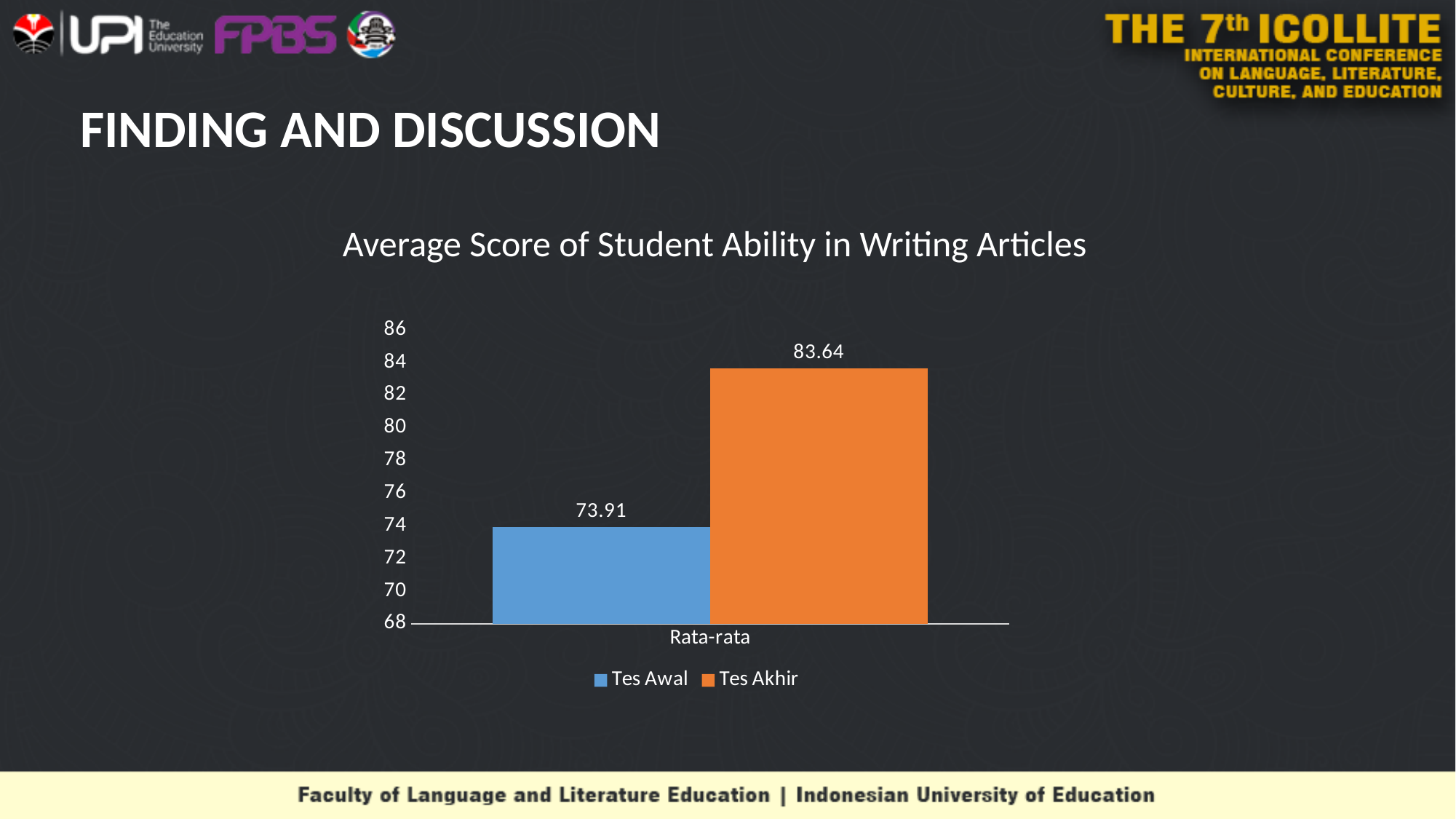
What is the difference between the Tes Akhir and Tes Awal values? 9.73 Is the value for Tes Awal greater or less than 76? less What is the title of the chart? Average Score of Student Ability in Writing Articles How many series does the legend list? 2 What kind of chart is shown? bar chart How many categories are shown on the x axis? 1 Which series has the lowest value? Tes Awal What is the value for Tes Akhir? 83.64 Which series has the higher value, Tes Awal or Tes Akhir? Tes Akhir What is the value for Tes Awal? 73.91 What colour is the Tes Akhir bar? orange Is the value for Tes Akhir greater or less than 80? greater